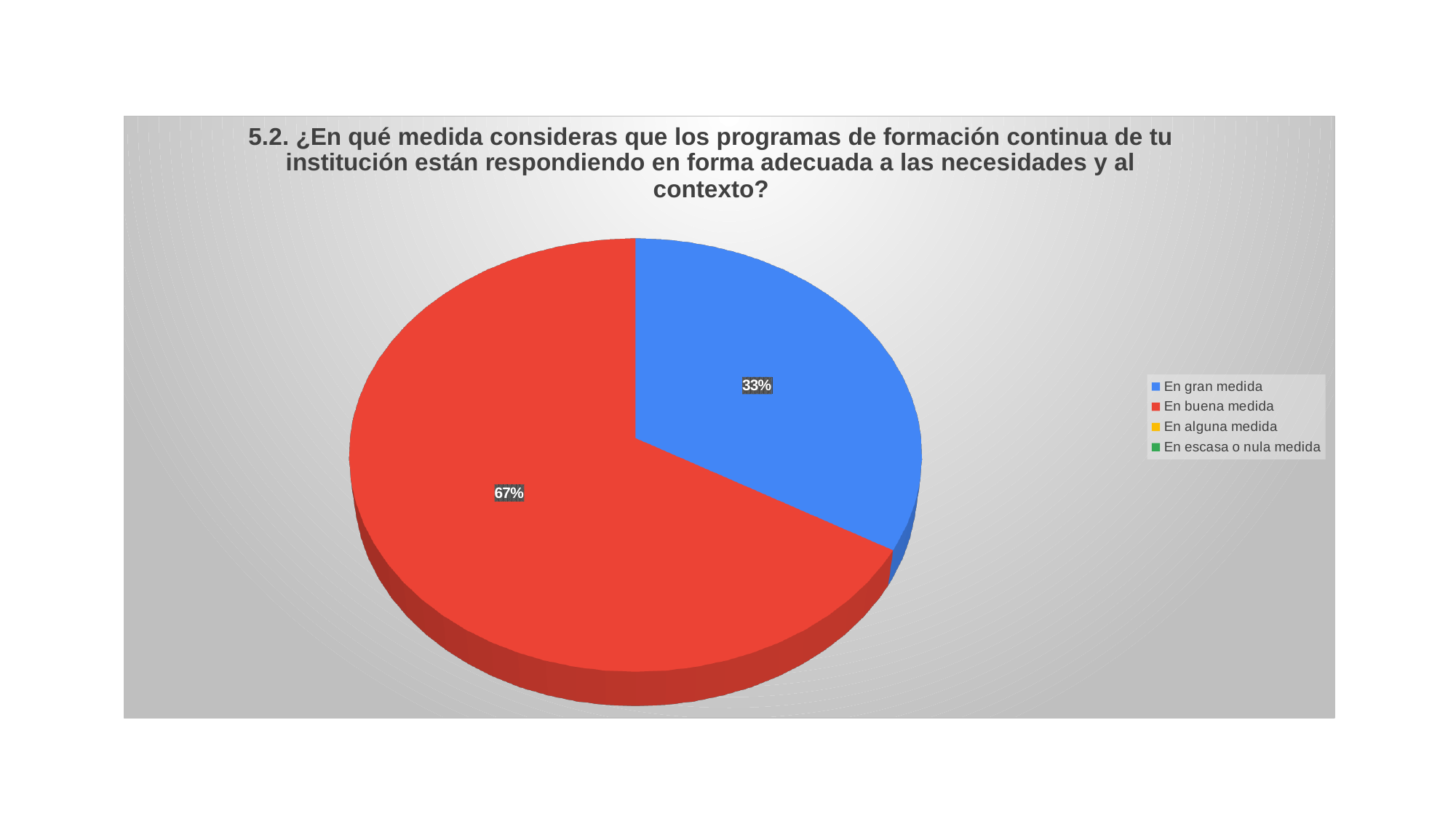
How many entries does the legend list? 4 What kind of chart is shown on the slide? pie chart What share of the pie does "En gran medida" have? 33% Is the share for "En buena medida" greater or less than 50%? greater What share of the pie does "En buena medida" have? 67% How many slices are visible in the pie? 2 What colour is the slice for "En gran medida"? blue What is the difference in percentage points between the "En buena medida" slice and the "En gran medida" slice? 34 Which is larger, the slice for "En gran medida" or the slice for "En buena medida"? En buena medida Which category has the largest slice of the pie? En buena medida Which legend entry is shown in red? En buena medida